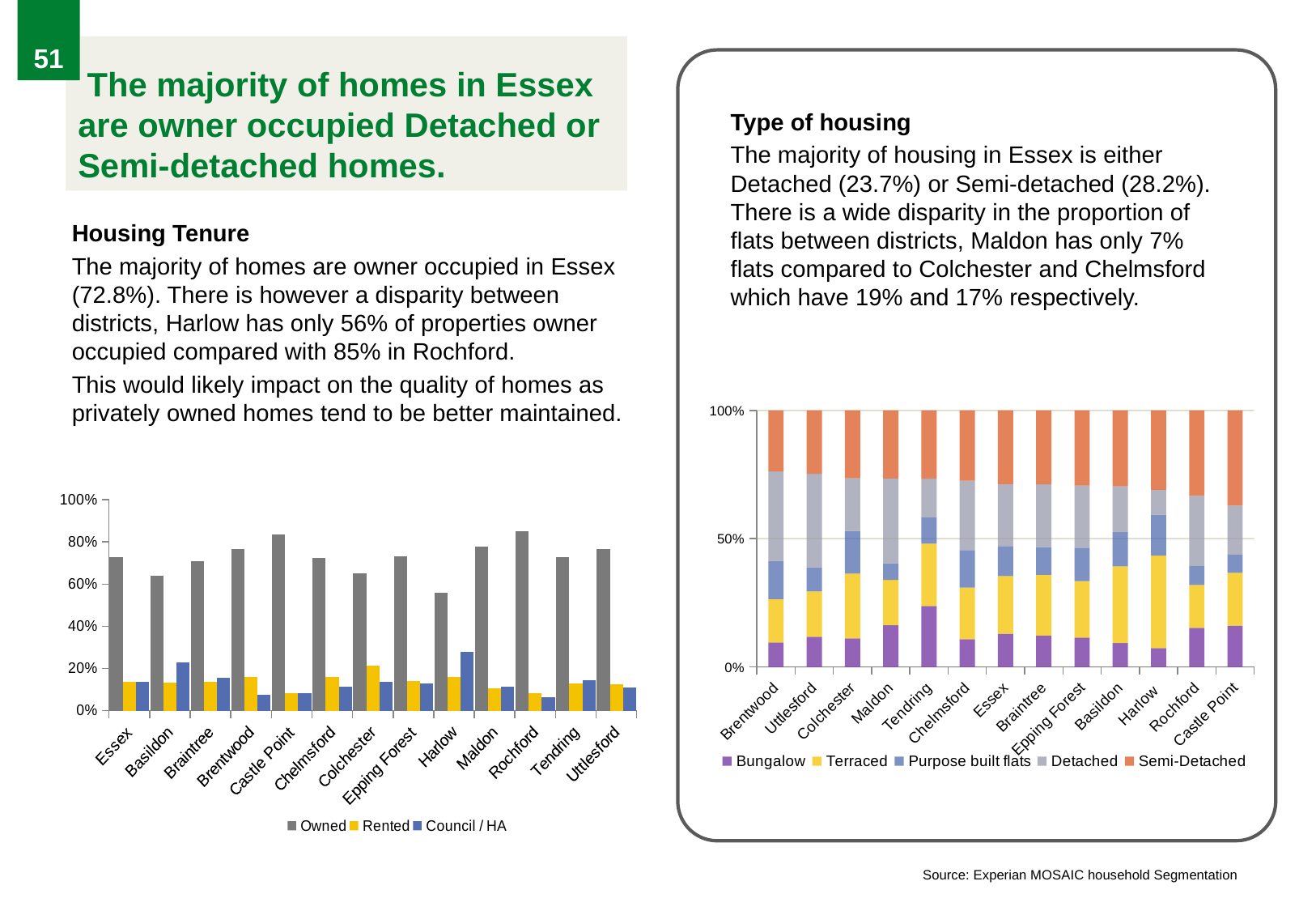
On the Type of housing chart on the right, which district has the largest Bungalow segment? Tendring On the Housing Tenure chart on the left, which district has the highest Owned value? Rochford On the Housing Tenure chart on the left, which district has the highest Council / HA value? Harlow On the Type of housing chart on the right, how many series does the legend list? 5 What kind of chart is the Type of housing chart on the right? Stacked bar chart On the Housing Tenure chart on the left, which is larger, the Council / HA value for Harlow or for Basildon? Harlow On the Housing Tenure chart on the left, is the Owned value for Harlow greater or less than 60%? less On the Housing Tenure chart on the left, is the Owned value for Rochford greater or less than 80%? greater On the Type of housing chart on the right, how many districts are shown on the x axis? 13 On the Housing Tenure chart on the left, which district has the lowest Owned value? Harlow On the Housing Tenure chart on the left, is the Rented value for Colchester greater or less than 20%? greater On the Housing Tenure chart on the left, how many series does the legend list? 3